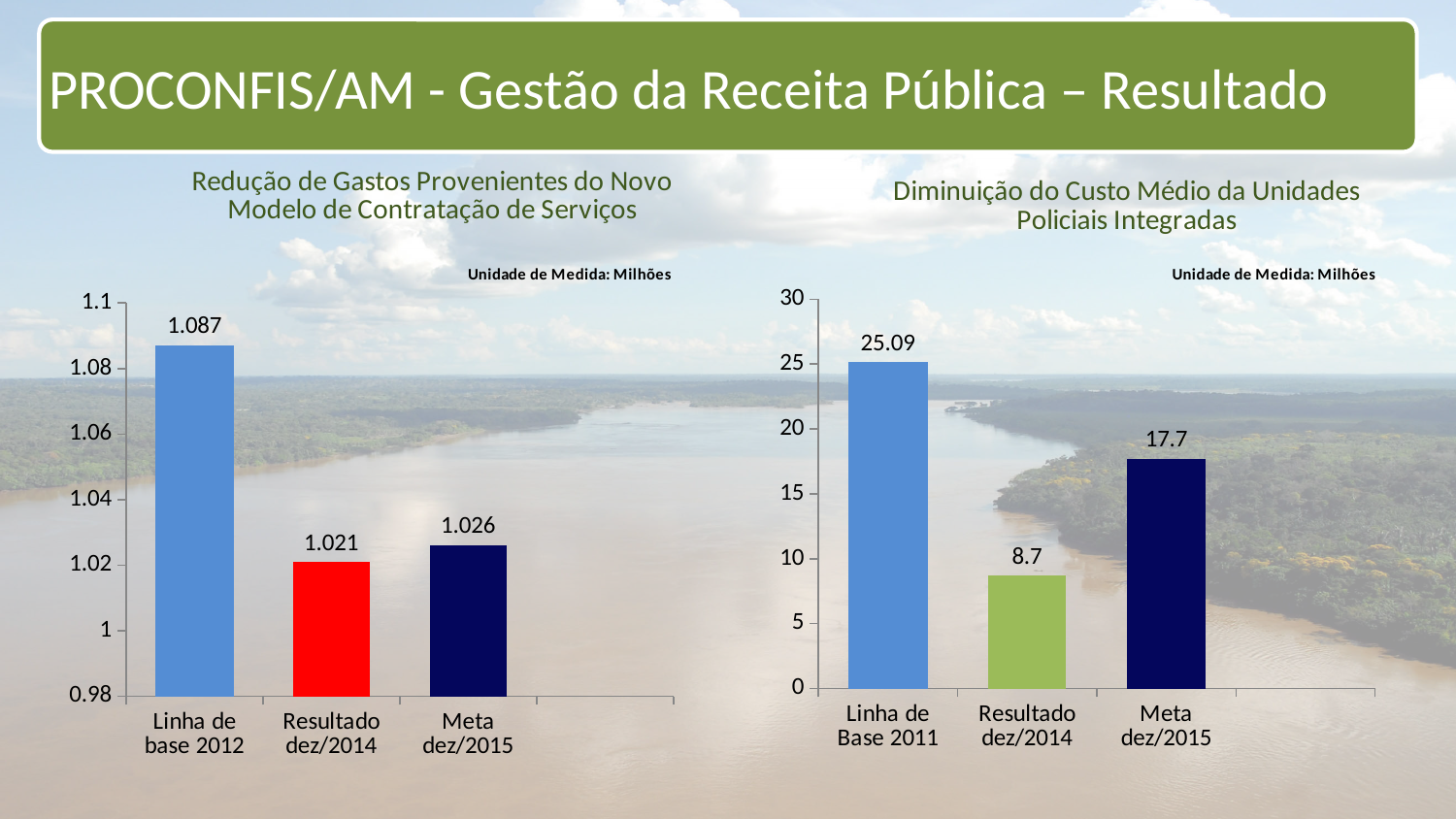
In the left chart (Redução de Gastos Provenientes do Novo Modelo de Contratação de Serviços), how many bars are plotted? 3 In the right chart (Diminuição do Custo Médio da Unidades Policiais Integradas), what is the value for Linha de Base 2011? 25.09 In the right chart (Diminuição do Custo Médio da Unidades Policiais Integradas), which category has the highest value? Linha de Base 2011 In the left chart (Redução de Gastos Provenientes do Novo Modelo de Contratação de Serviços), which category has the lowest value? Resultado dez/2014 In the left chart (Redução de Gastos Provenientes do Novo Modelo de Contratação de Serviços), what is the difference between Linha de base 2012 and Meta dez/2015? 0.061 In the right chart (Diminuição do Custo Médio da Unidades Policiais Integradas), what is the difference between Meta dez/2015 and Resultado dez/2014? 9 In the right chart (Diminuição do Custo Médio da Unidades Policiais Integradas), which is larger: Resultado dez/2014 or Meta dez/2015? Meta dez/2015 In the right chart (Diminuição do Custo Médio da Unidades Policiais Integradas), what is the value for Meta dez/2015? 17.7 What unit of measure is stated for the left chart (Redução de Gastos Provenientes do Novo Modelo de Contratação de Serviços)? Milhões In the left chart (Redução de Gastos Provenientes do Novo Modelo de Contratação de Serviços), what is the value for Resultado dez/2014? 1.021 In the left chart (Redução de Gastos Provenientes do Novo Modelo de Contratação de Serviços), what is the value for Linha de base 2012? 1.087 What type of chart is the right chart (Diminuição do Custo Médio da Unidades Policiais Integradas)? Bar chart